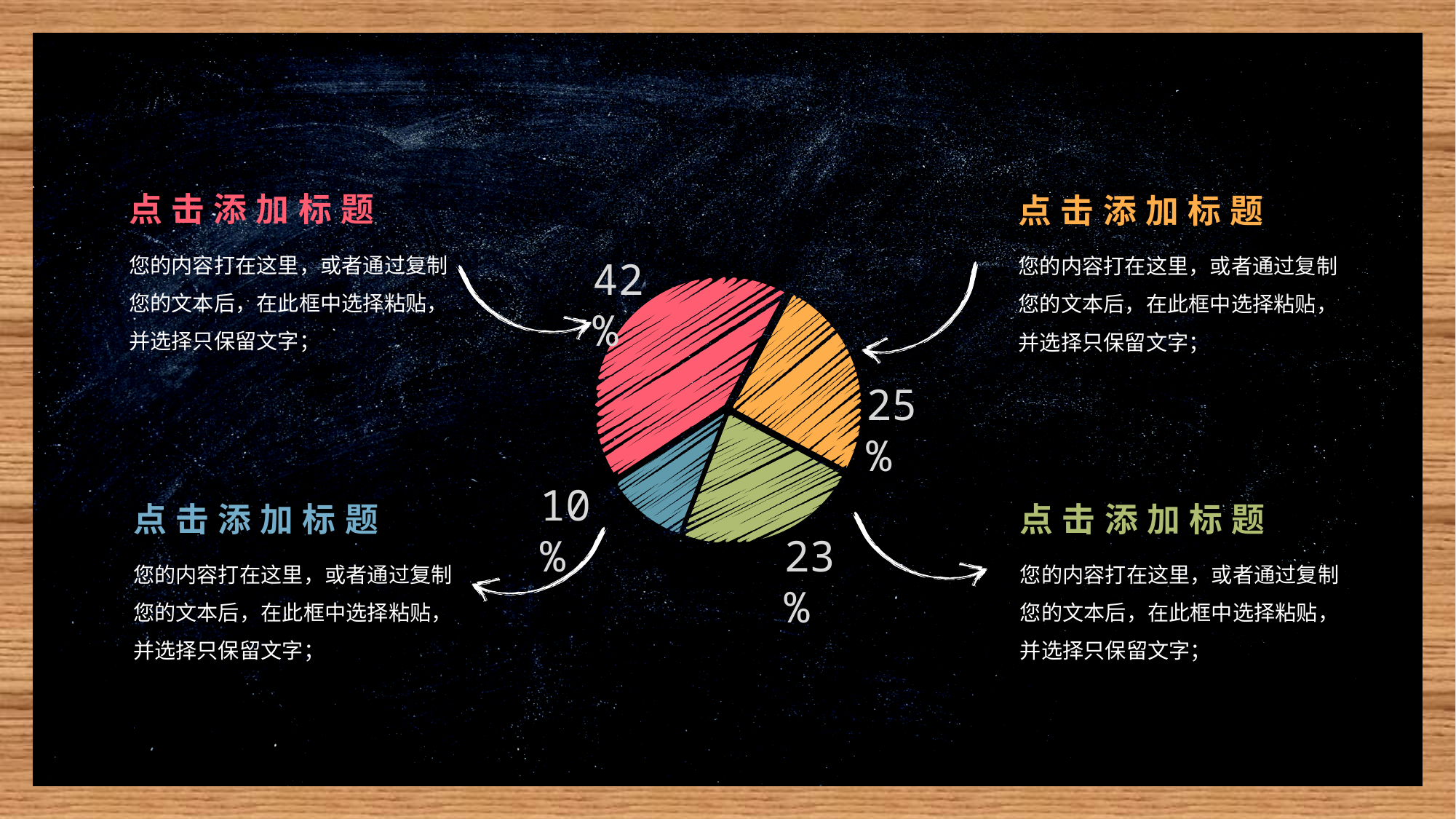
What is the difference in percentage points between the orange slice and the green slice? 2 What percentage is shown for the red slice of the pie chart? 42% Which colour slice of the pie chart is the largest? red Which is larger, the orange slice or the green slice? orange What percentage is shown for the orange slice of the pie chart? 25% What is the difference in percentage points between the red slice and the blue slice? 32 What is the combined share of the red and orange slices? 67% How many slices does the pie chart have? 4 What percentage is shown for the green slice of the pie chart? 23% What percentage is shown for the blue slice of the pie chart? 10% Which colour slice of the pie chart is the smallest? blue What kind of chart is shown on the slide? pie chart